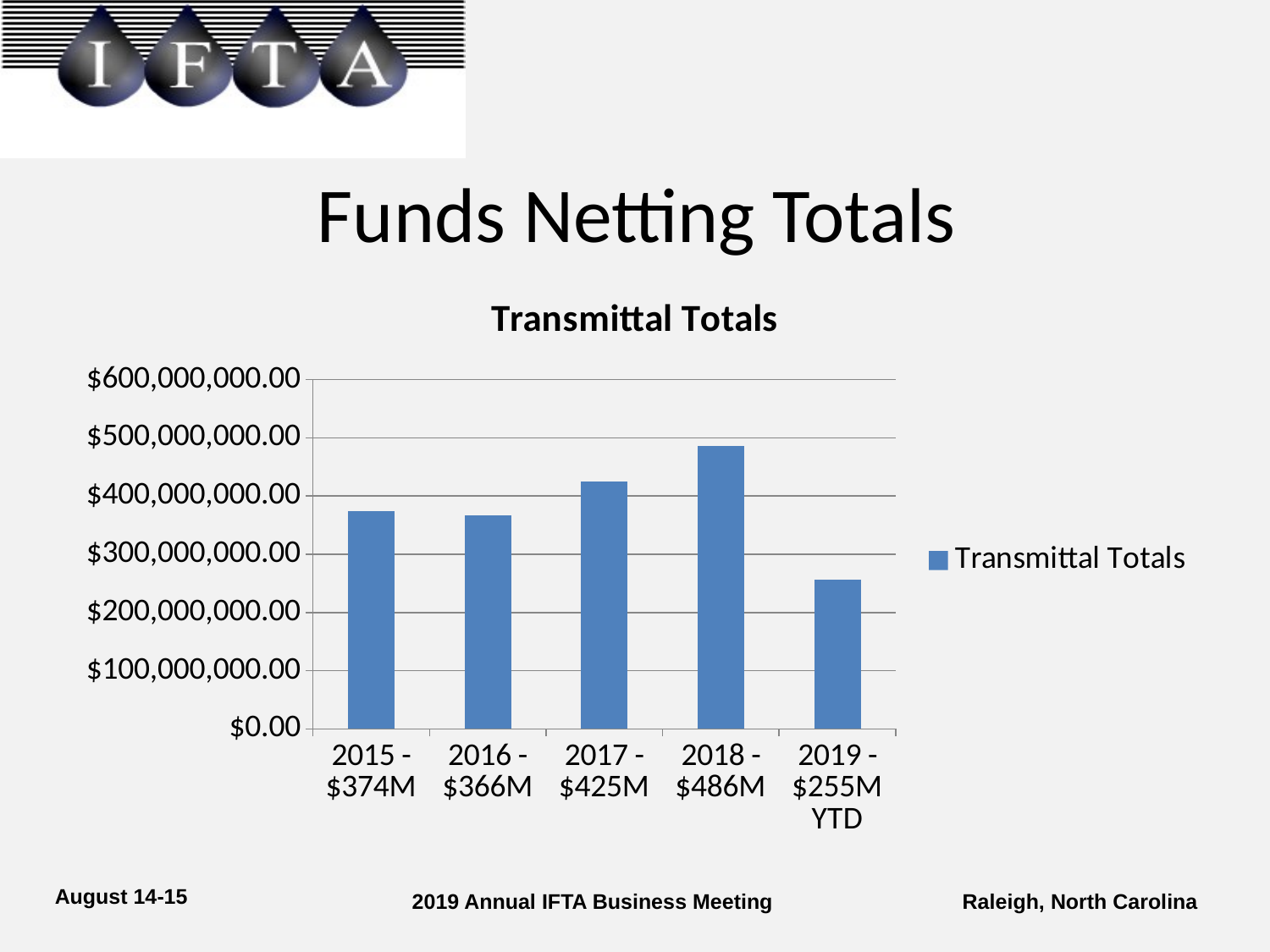
Which is larger, the transmittal total for 2015 or for 2016? 2015 Do the transmittal totals rise or fall from 2016 to 2018? rise Which year has the highest transmittal total? 2018 How many series does the legend list? 1 Is the transmittal total for 2018 greater or less than $400,000,000.00? greater How many bars are plotted in the chart? 5 What type of chart is shown on the slide? bar chart What transmittal total is shown for 2019 YTD in the category label? $255M What is the title of the chart? Transmittal Totals Using the values in the category labels, what is the difference between the 2018 and 2015 transmittal totals? $112M Which year has the lowest transmittal total? 2019 (YTD) What transmittal total is shown for 2017 in the category label? $425M